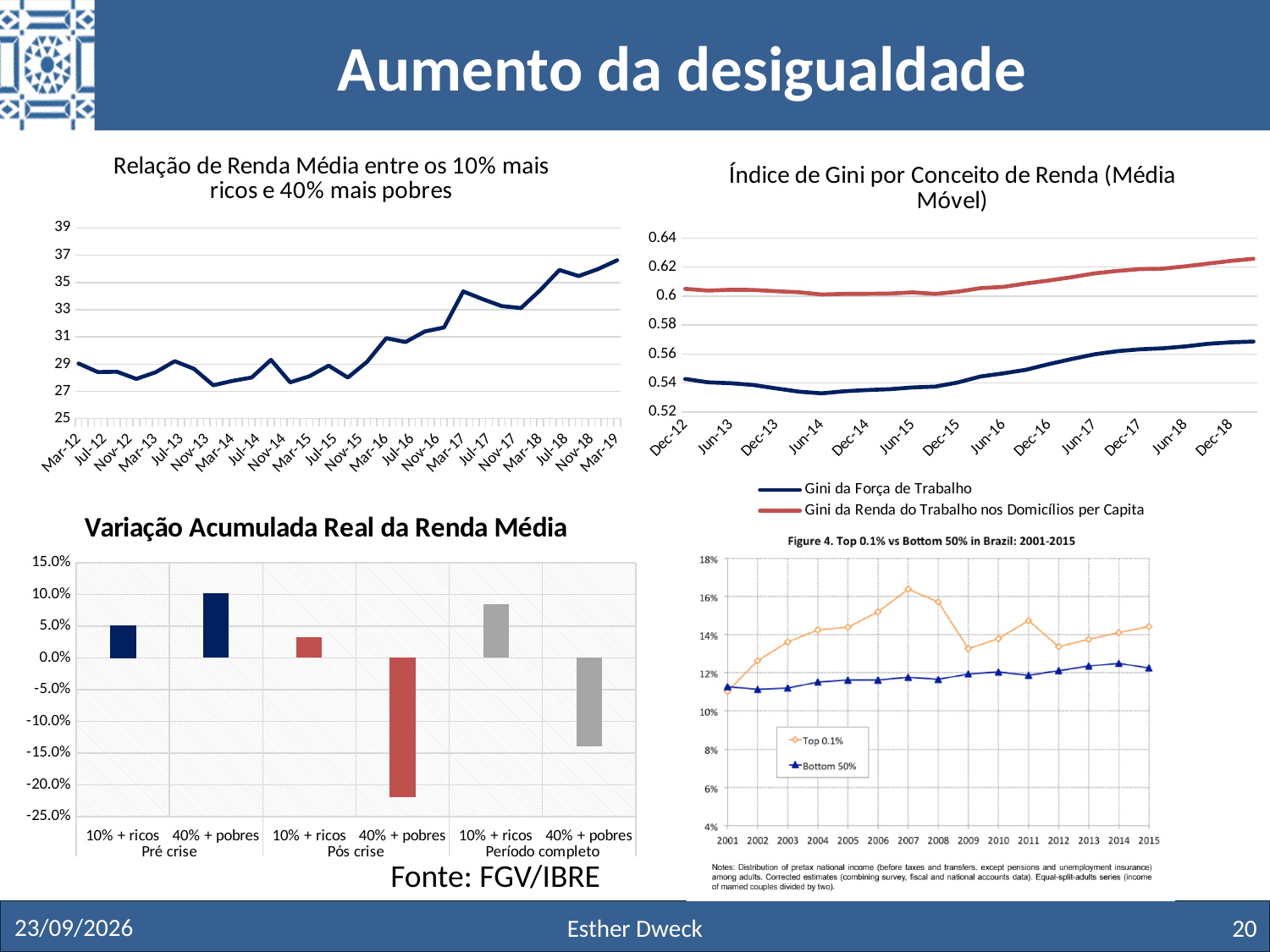
What kind of chart is the 'Variação Acumulada Real da Renda Média' chart? Bar chart In the 'Relação de Renda Média entre os 10% mais ricos e 40% mais pobres' chart, is the value for Mar-14 greater or less than 29? Less In the 'Índice de Gini por Conceito de Renda (Média Móvel)' chart, which series has the higher value at Dec-18? Gini da Renda do Trabalho nos Domicílios per Capita In the 'Variação Acumulada Real da Renda Média' chart, is the value for 40% + pobres in Pós crise greater or less than -20.0%? Less What kind of chart is the 'Relação de Renda Média entre os 10% mais ricos e 40% mais pobres' chart? Line chart In the 'Figure 4. Top 0.1% vs Bottom 50% in Brazil: 2001-2015' chart, in which year is the Top 0.1% series highest? 2007 In the 'Relação de Renda Média entre os 10% mais ricos e 40% mais pobres' chart, do the values overall rise or fall from Mar-12 to Mar-19? Rise In the 'Variação Acumulada Real da Renda Média' chart, which bar has the lowest value? 40% + pobres, Pós crise How many bars are plotted in the 'Variação Acumulada Real da Renda Média' chart? 6 How many series does the legend of the 'Índice de Gini por Conceito de Renda (Média Móvel)' chart list? 2 In the 'Relação de Renda Média entre os 10% mais ricos e 40% mais pobres' chart, is the value for Mar-19 greater or less than 35? Greater